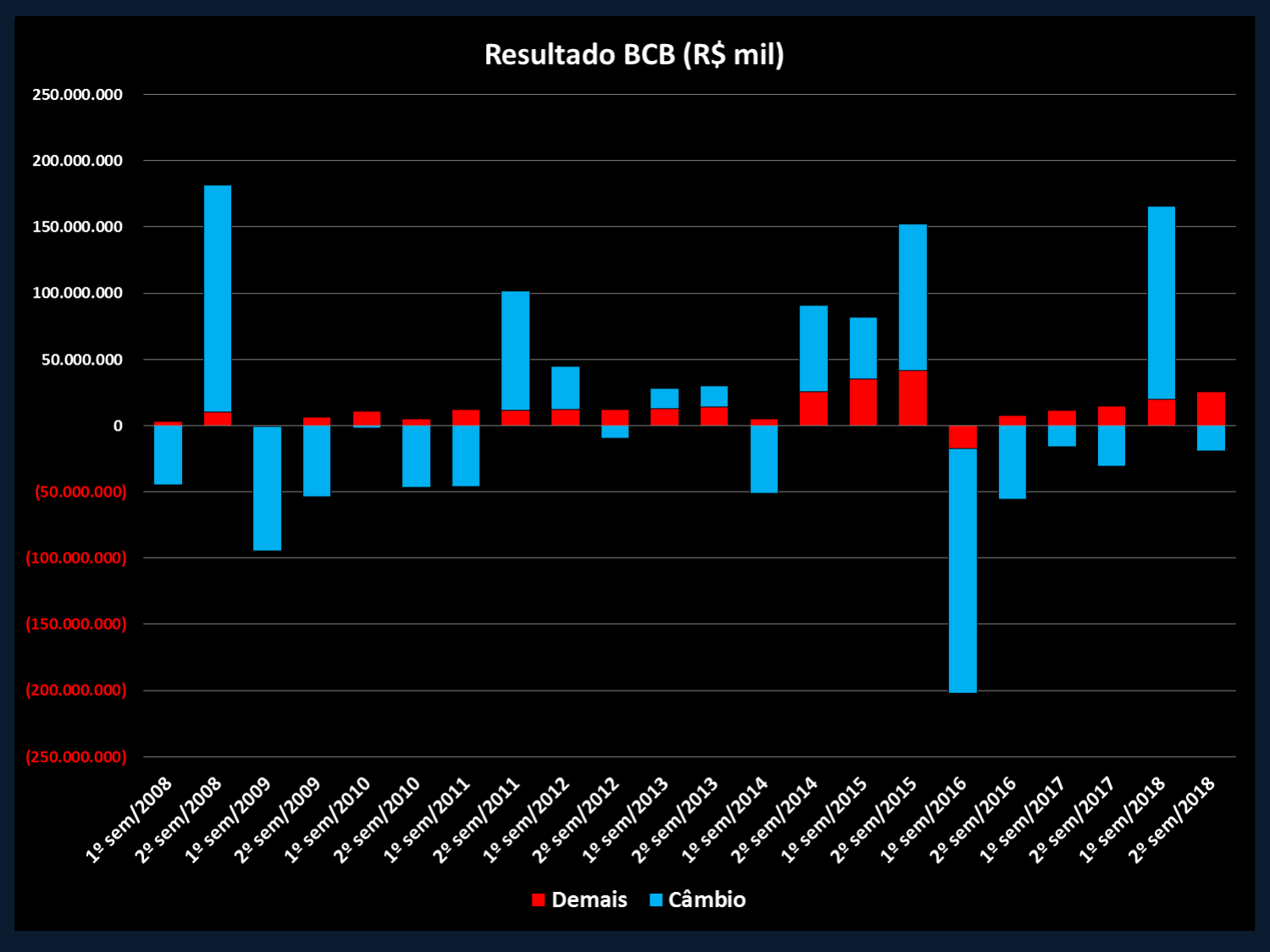
What kind of chart is shown on the slide? bar chart How many series does the legend list? 2 Which is larger, the Demais value for 2º sem/2014 or for 2º sem/2015? 2º sem/2015 Which semester has the highest Câmbio value? 2º sem/2008 Which semester has the lowest (most negative) Câmbio value? 1º sem/2016 Is the Câmbio value for 1º sem/2016 greater or less than (150.000.000)? less Is the Câmbio value for 1º sem/2009 greater or less than (50.000.000)? less What is the title of the chart? Resultado BCB (R$ mil) How many semester categories are shown on the x axis? 22 Is the Câmbio value for 2º sem/2008 greater or less than 150.000.000? greater Which colour represents the Câmbio series? blue